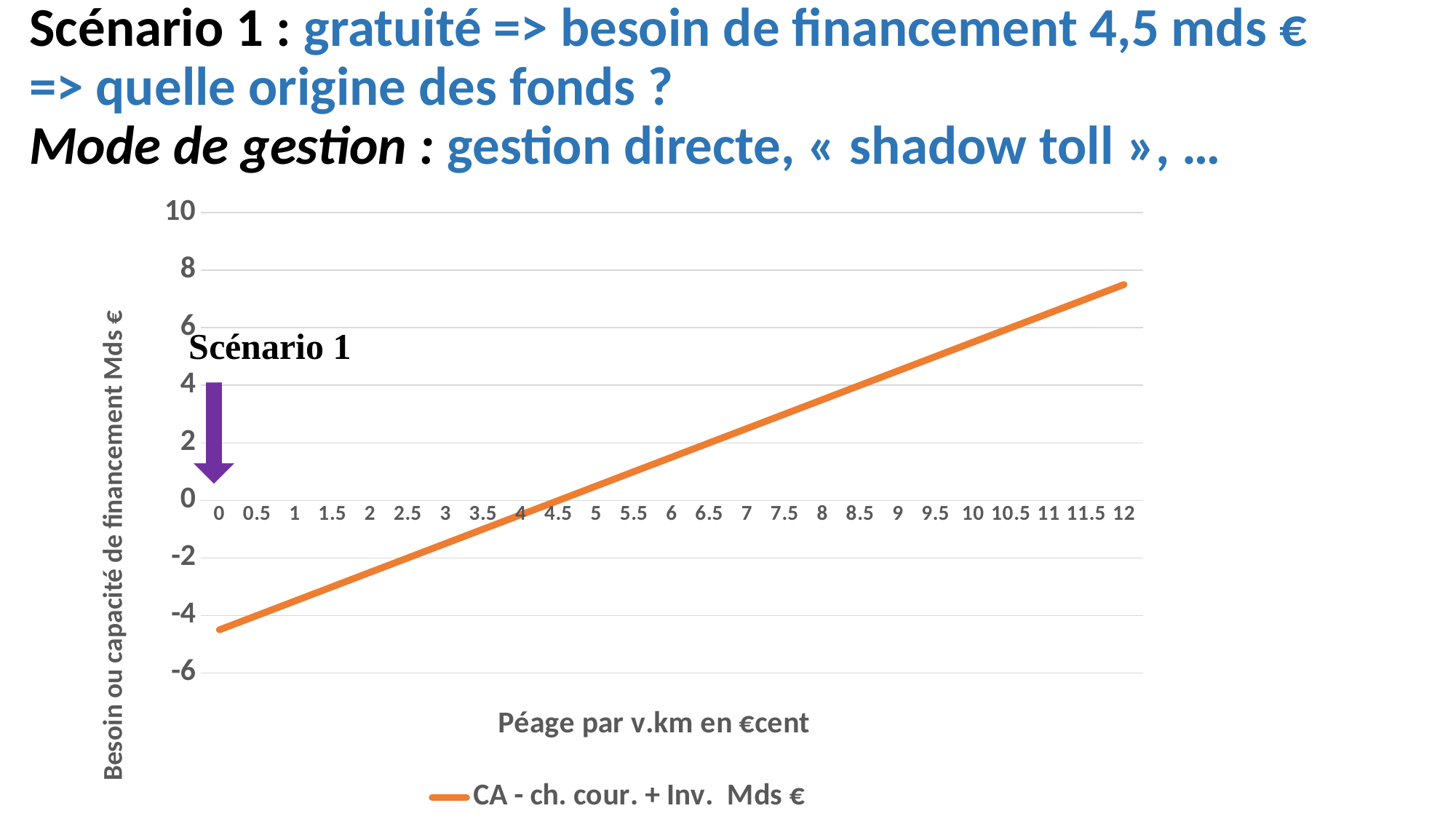
How many series does the legend list? 1 Is the value at a toll of 12 €cent greater or less than 6? greater Is the value at a toll of 8 €cent greater or less than 2? greater Is the value at a toll of 0 €cent greater or less than -4? less What is the title of the x axis? Péage par v.km en €cent At which x-axis value is the plotted line lowest? 0 Do the values rise or fall as the toll per v.km increases along the x axis? rise What is the legend entry for the plotted series? CA - ch. cour. + Inv. Mds € What kind of chart is shown on the slide? line chart Which is larger, the value at a toll of 6 €cent or the value at a toll of 3 €cent? 6 €cent At which x-axis value is the plotted line highest? 12